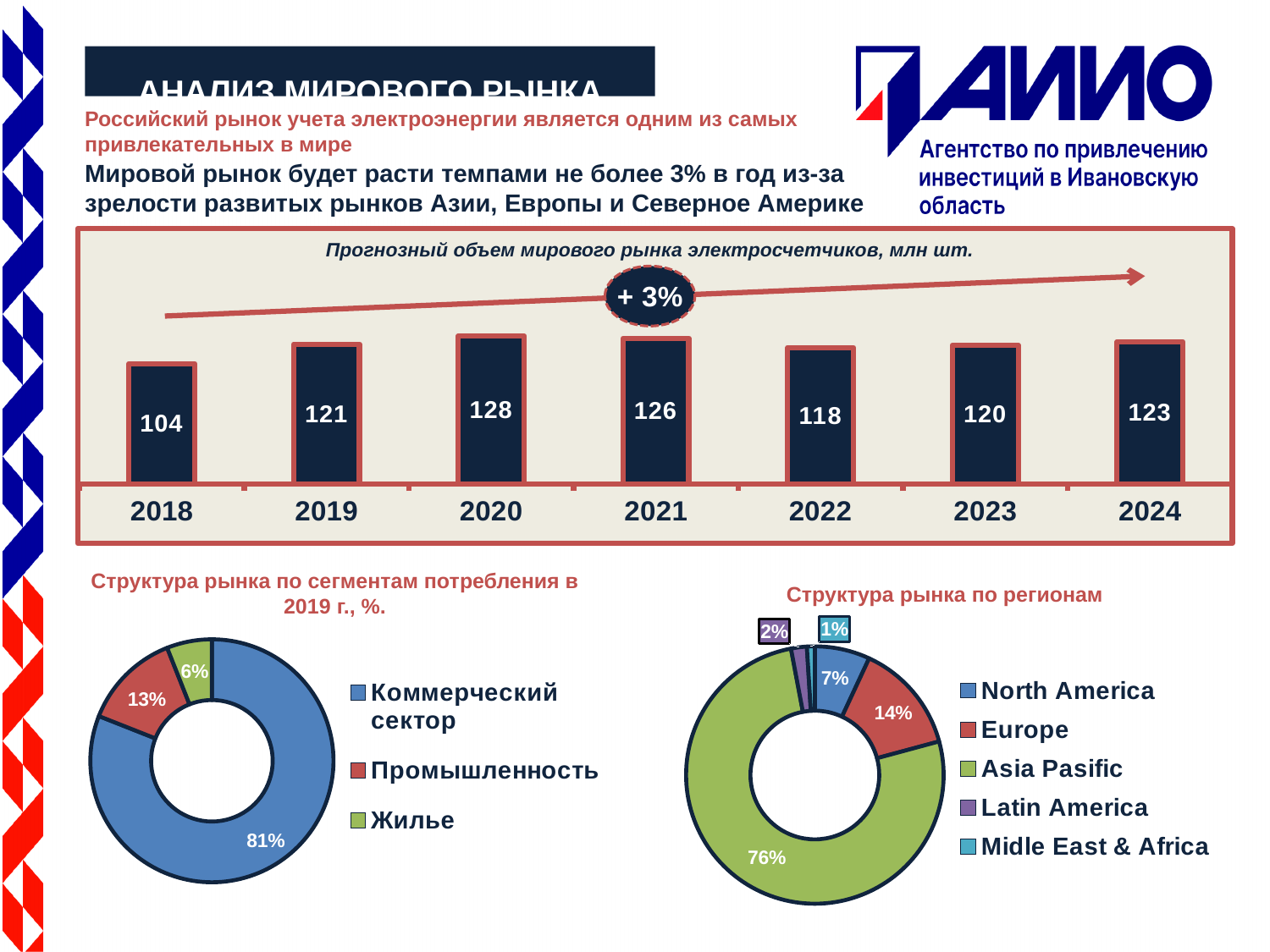
In the chart 'Структура рынка по регионам', what is the share of Europe? 14% In the bar chart 'Прогнозный объем мирового рынка электросчетчиков, млн шт.', what is the difference between the values for 2019 and 2018? 17 In the bar chart 'Прогнозный объем мирового рынка электросчетчиков, млн шт.', which year has the highest value? 2020 How many regions does the legend of the chart 'Структура рынка по регионам' list? 5 How many years are shown in the bar chart 'Прогнозный объем мирового рынка электросчетчиков, млн шт.'? 7 In the chart 'Структура рынка по сегментам потребления в 2019 г., %.', what is the share of Промышленность? 13% In the chart 'Структура рынка по сегментам потребления в 2019 г., %.', which segment has the largest share? Коммерческий сектор In the bar chart 'Прогнозный объем мирового рынка электросчетчиков, млн шт.', what is the value for 2020? 128 In the bar chart 'Прогнозный объем мирового рынка электросчетчиков, млн шт.', which is larger, the value for 2022 or the value for 2024? 2024 In the chart 'Структура рынка по регионам', which region has the smallest share? Midle East & Africa What type of chart is 'Прогнозный объем мирового рынка электросчетчиков, млн шт.'? bar chart In the bar chart 'Прогнозный объем мирового рынка электросчетчиков, млн шт.', which year has the lowest value? 2018